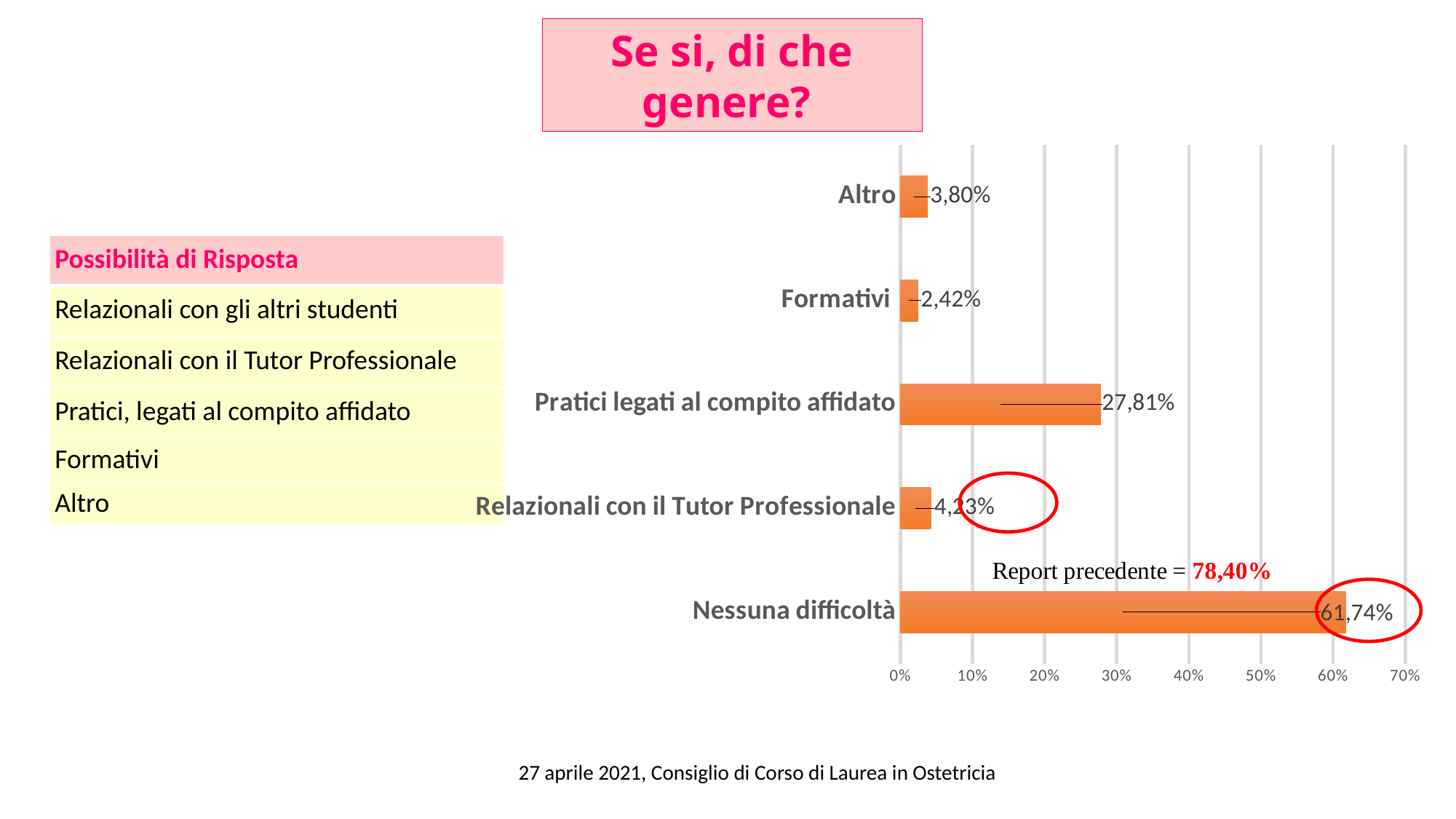
Is the value for Nessuna difficoltà greater or less than 50%? greater What value is given for the 'Report precedente' annotation on the chart? 78,40% What is the value for Relazionali con il Tutor Professionale? 4,23% What is the value for Nessuna difficoltà? 61,74% Which category has the highest value? Nessuna difficoltà What is the value for Formativi? 2,42% Which is larger, Altro or Relazionali con il Tutor Professionale? Relazionali con il Tutor Professionale What is the difference between Nessuna difficoltà and Pratici legati al compito affidato? 33,93% What kind of chart is shown on the slide? bar chart How many categories does the chart show? 5 Which category has the lowest value? Formativi What is the value for Pratici legati al compito affidato? 27,81%